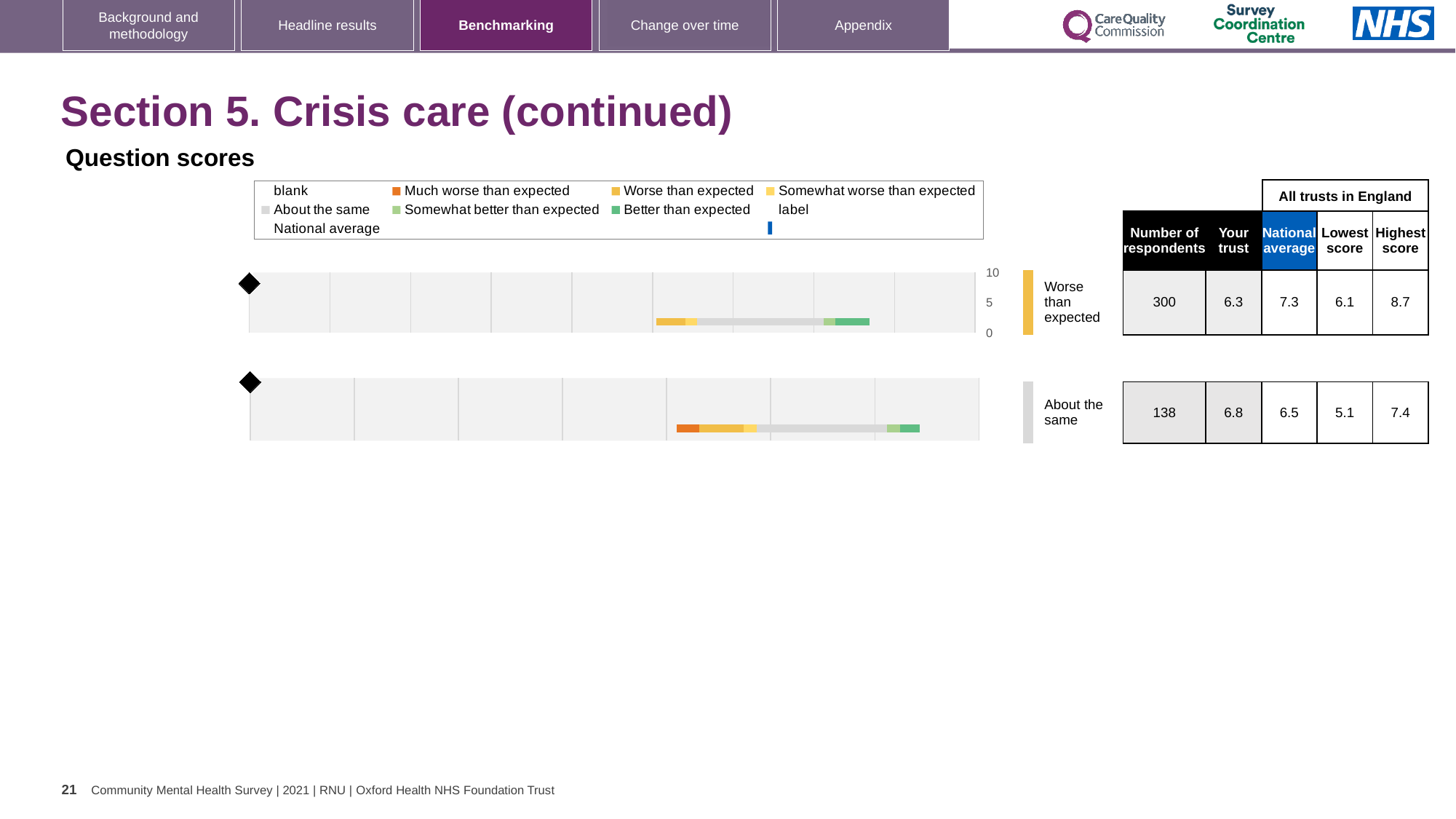
For the top chart, rated 'Worse than expected', what is the 'Your trust' score shown in the table? 6.3 For the bottom chart, rated 'About the same', which is larger: the 'Your trust' score or the national average? Your trust For the top chart, rated 'Worse than expected', how many respondents are listed? 300 In the legend, which colour represents 'Much worse than expected'? Orange How many benchmarking charts are shown on the slide? 2 For the bottom chart, rated 'About the same', what is the 'Your trust' score? 6.8 For the top chart, rated 'Worse than expected', what is the difference between the national average and the 'Your trust' score? 1.0 For the bottom chart, rated 'About the same', what is the highest score among all trusts in England? 7.4 For the top chart, rated 'Worse than expected', what is the national average score? 7.3 What kind of chart is used for the benchmarking displays on this slide? Bar chart For the bottom chart, rated 'About the same', what is the lowest score among all trusts in England? 5.1 For the top chart, rated 'Worse than expected', which is larger: the 'Your trust' score or the national average? National average